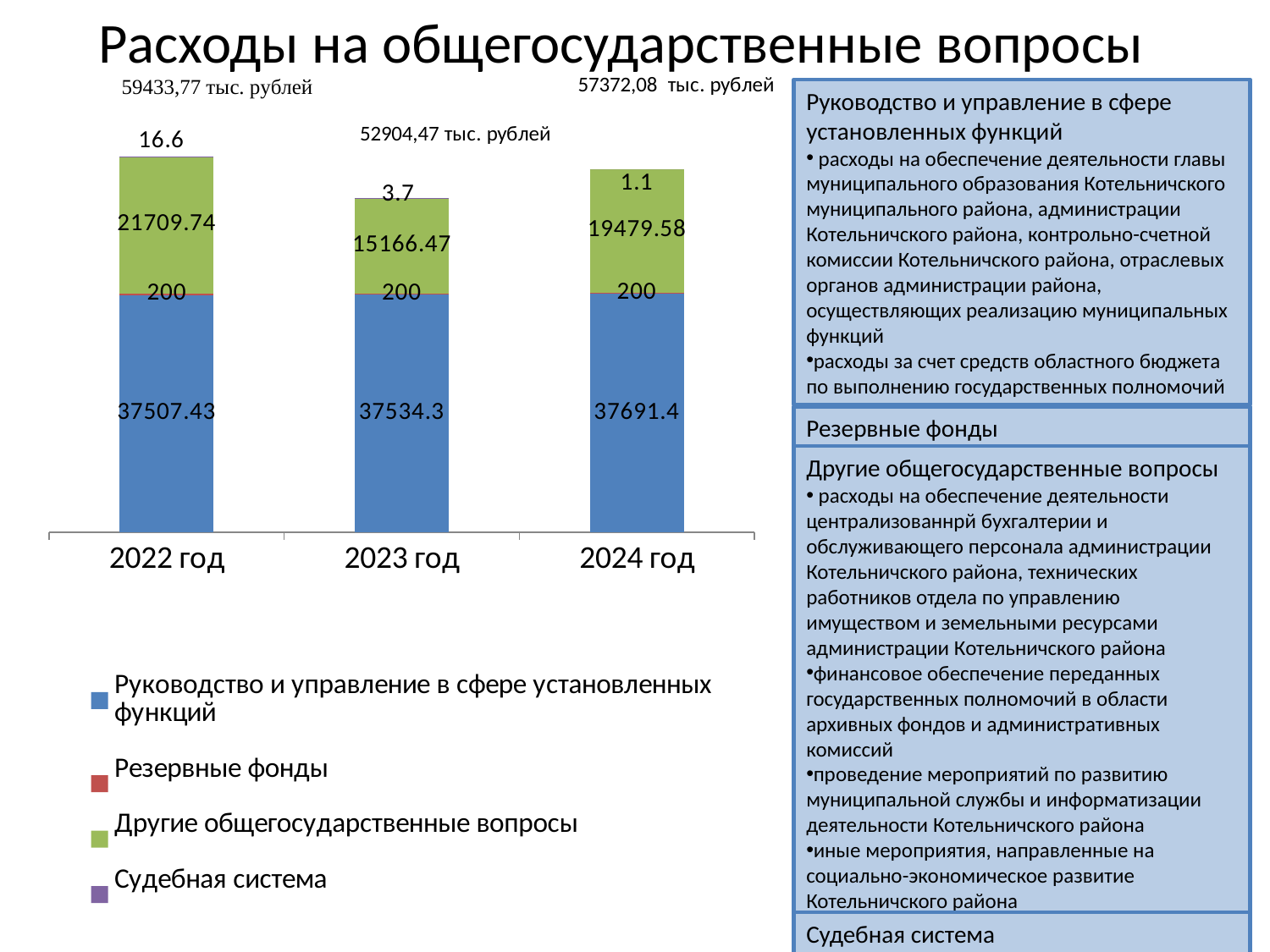
Which year has the larger value for Руководство и управление в сфере установленных функций, 2022 год or 2024 год? 2024 год What is the value for Резервные фонды in 2023 год? 200 How many years are shown on the x axis of the chart? 3 What is the difference between the Другие общегосударственные вопросы values for 2022 год and 2023 год? 6543.27 What is the value for Другие общегосударственные вопросы in 2023 год? 15166.47 What is the value for Руководство и управление в сфере установленных функций in 2022 год? 37507.43 In which year is the value for Судебная система the lowest? 2024 год What is the value for Судебная система in 2024 год? 1.1 What kind of chart is shown on the slide? Stacked bar chart How many series does the chart legend list? 4 In which year is the value for Другие общегосударственные вопросы the highest? 2022 год Does the value for Судебная система rise or fall from 2022 год to 2024 год? Fall